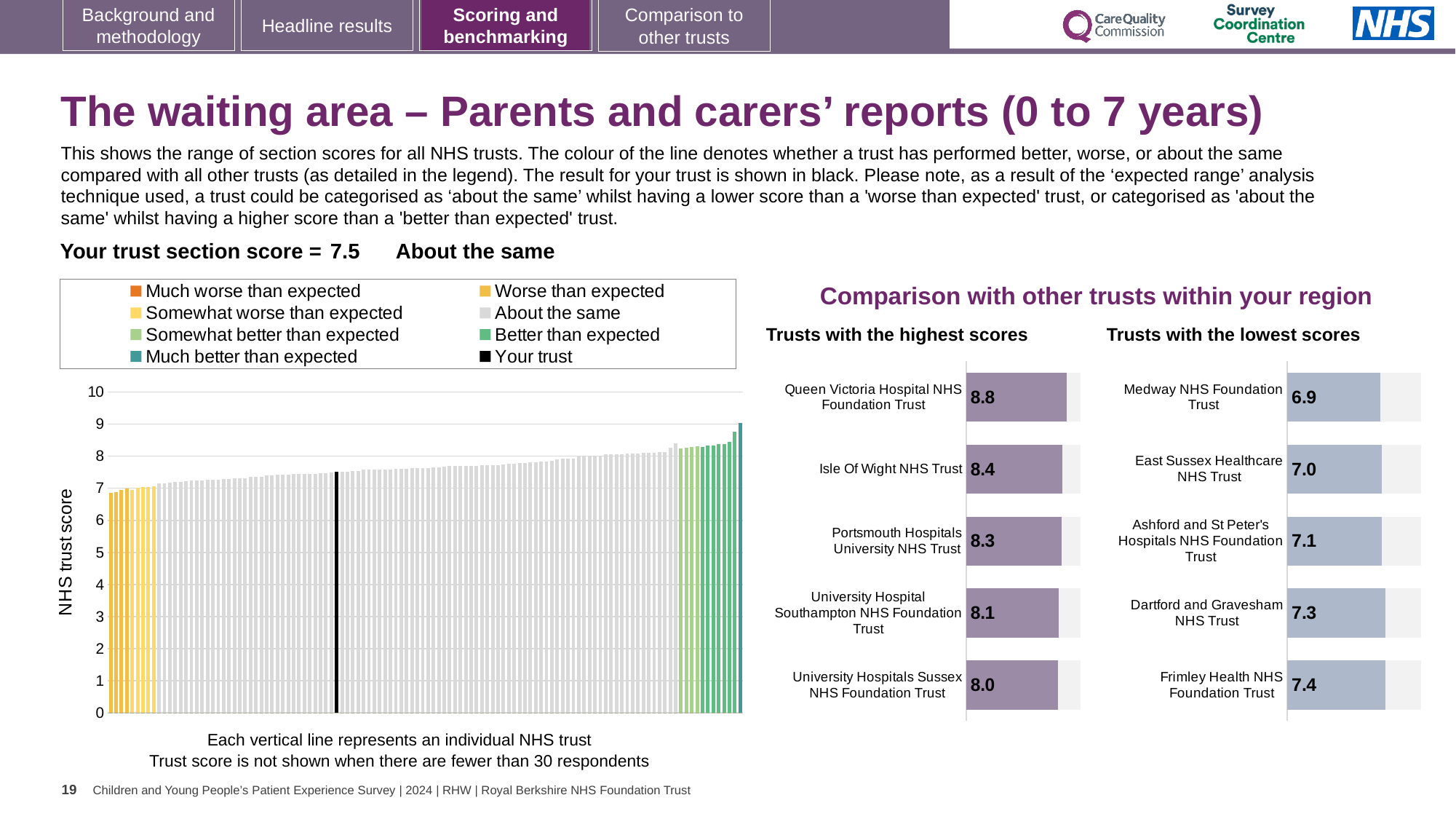
How many entries does the legend of the NHS trust score chart on the left list? 8 In the 'Trusts with the highest scores' chart, which trust has the highest score? Queen Victoria Hospital NHS Foundation Trust In the 'Trusts with the lowest scores' chart, which trust has the lowest score? Medway NHS Foundation Trust In the 'Trusts with the lowest scores' chart, what is the difference between the scores of Frimley Health NHS Foundation Trust and Medway NHS Foundation Trust? 0.5 In the 'Trusts with the highest scores' chart, which has the higher score: Isle Of Wight NHS Trust or Portsmouth Hospitals University NHS Trust? Isle Of Wight NHS Trust In the NHS trust score chart on the left, do the values rise or fall from left to right? rise In the 'Trusts with the highest scores' chart, what is the difference between the scores of Queen Victoria Hospital NHS Foundation Trust and University Hospitals Sussex NHS Foundation Trust? 0.8 In the NHS trust score chart on the left, what colour is the bar for your trust? black In the 'Trusts with the highest scores' chart, what is the score for Queen Victoria Hospital NHS Foundation Trust? 8.8 How many trusts are shown in the 'Trusts with the lowest scores' chart? 5 In the 'Trusts with the lowest scores' chart, what is the score for Medway NHS Foundation Trust? 6.9 What kind of chart is the NHS trust score chart on the left of the slide? bar chart